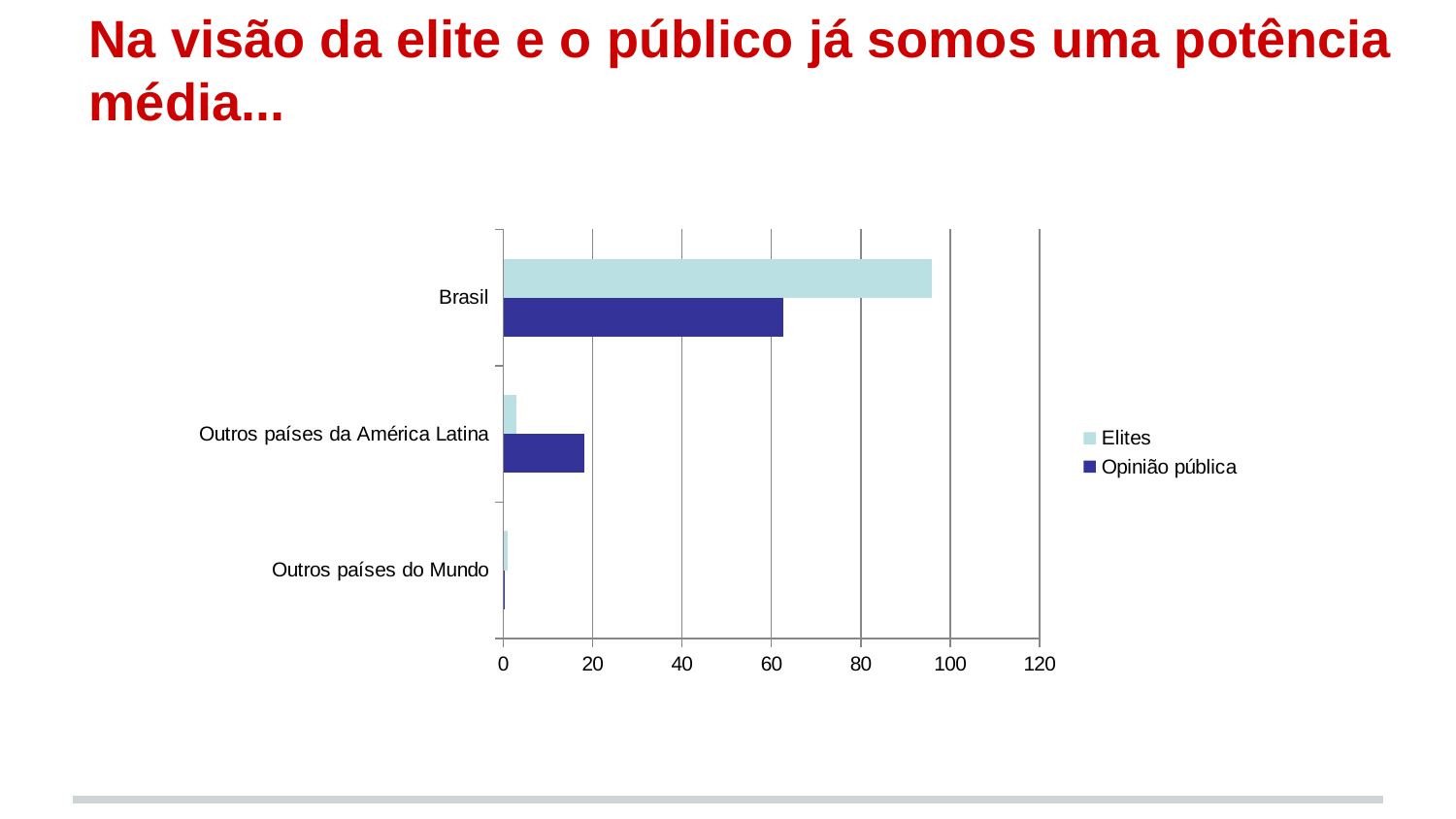
What are the two series named in the legend? Elites and Opinião pública Which category has the lowest value for the Opinião pública series? Outros países do Mundo How many categories are shown on the chart? 3 Is the Opinião pública value for Brasil greater or less than 80? less Is the Opinião pública value for Outros países da América Latina greater or less than 40? less For Outros países da América Latina, which series has the larger value, Elites or Opinião pública? Opinião pública For Brasil, which series has the larger value, Elites or Opinião pública? Elites Is the Elites value for Outros países da América Latina greater or less than 20? less How many series does the legend list? 2 What kind of chart is shown on the slide? bar chart Which category has the highest value for the Elites series? Brasil